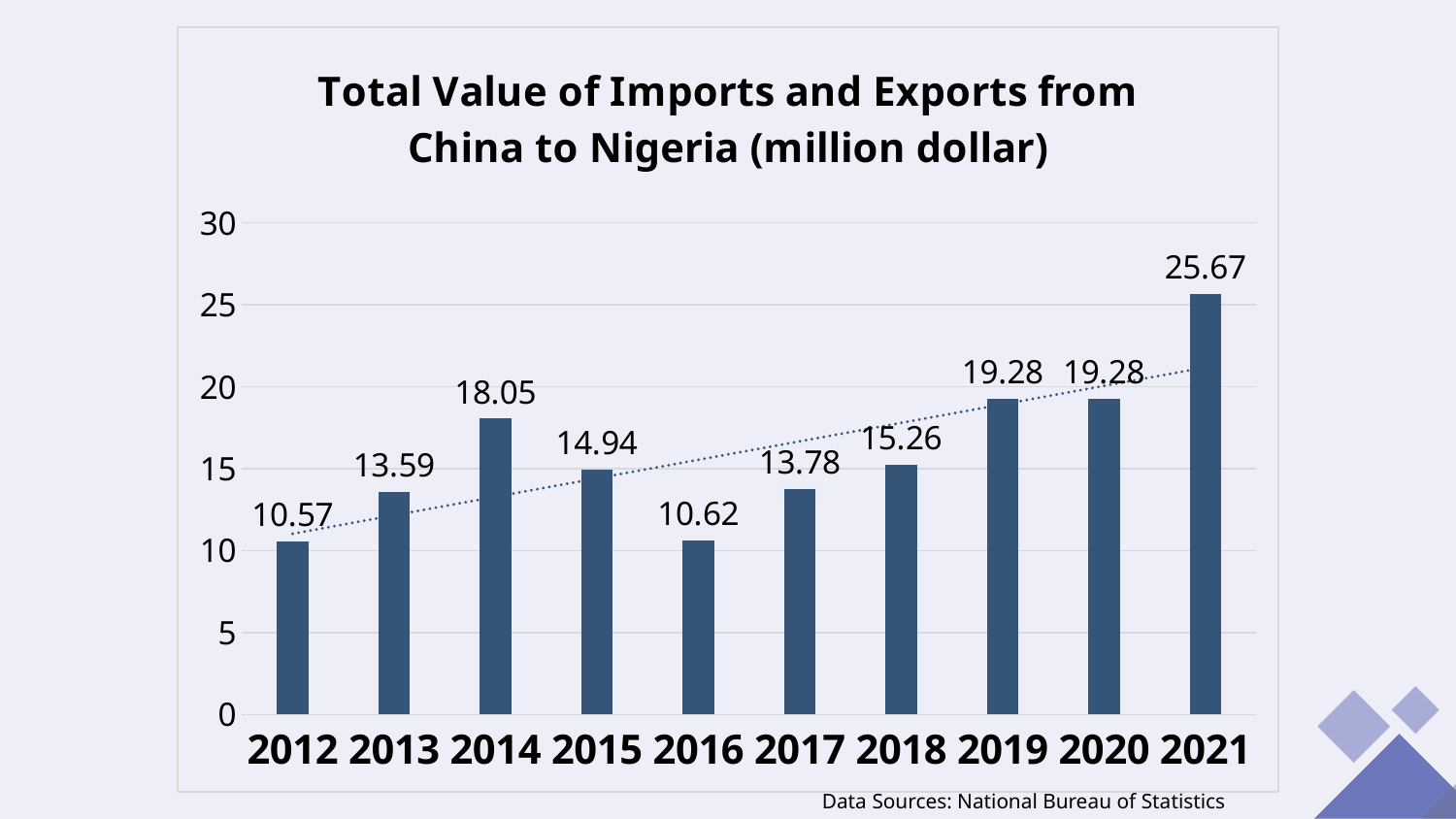
What is the value for 2014? 18.05 Which year has the lowest value? 2012 What is the title of the chart? Total Value of Imports and Exports from China to Nigeria (million dollar) Which year has the highest value? 2021 Do the values generally rise or fall from 2016 to 2021? rise Which is larger, the value for 2014 or the value for 2015? 2014 What is the value for 2016? 10.62 What kind of chart is this? bar chart What is the value for 2021? 25.67 What is the difference between the values for 2021 and 2020? 6.39 Is the value for 2019 greater or less than 15? greater How many years are shown on the x axis? 10